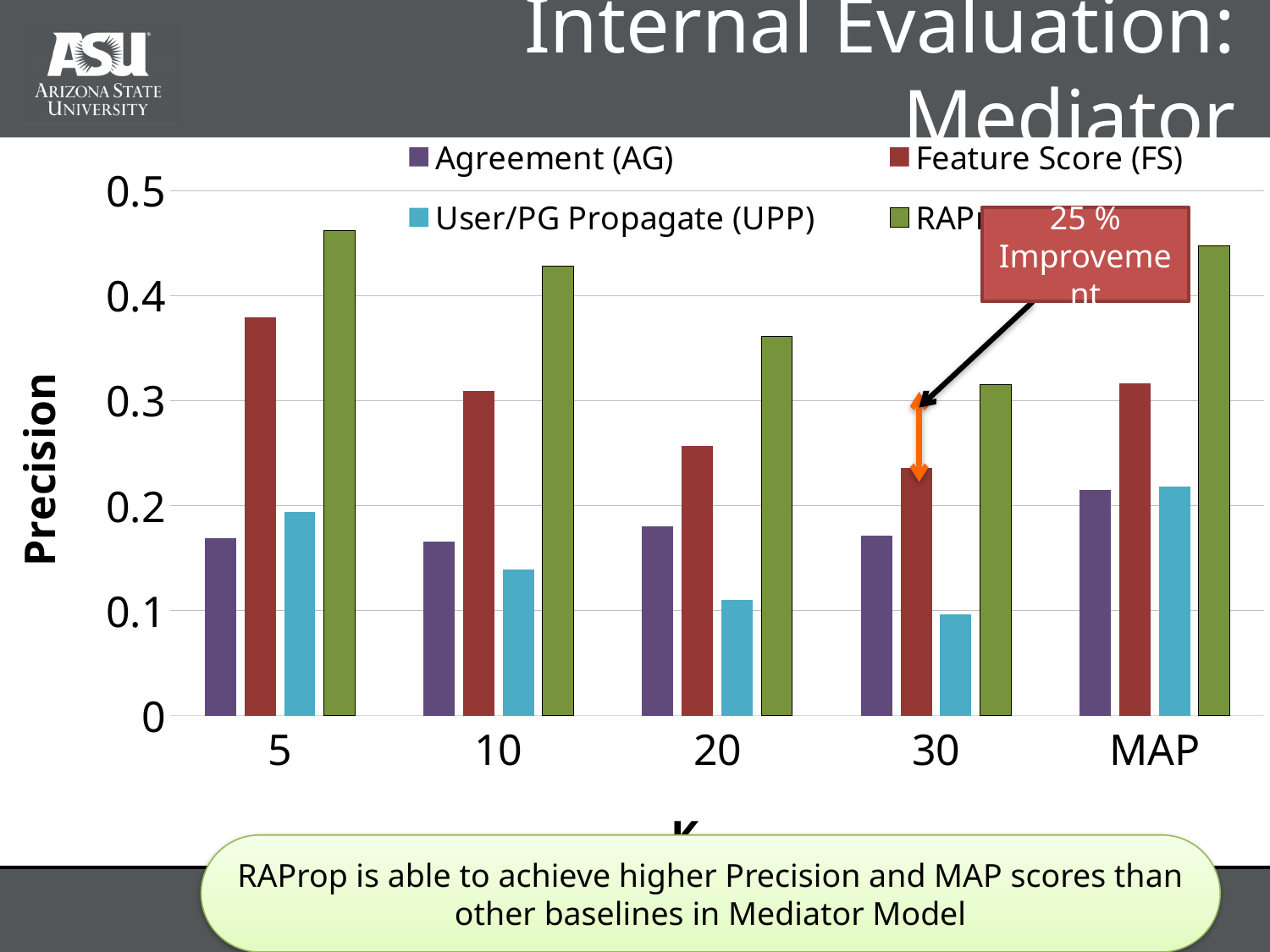
How many categories are shown along the x axis? 5 What kind of chart is shown on the slide? bar chart Which series has the highest precision at K = 5? RAProp What is the label on the y axis of the chart? Precision Is the Feature Score (FS) value larger at K = 5 or at K = 30? 5 How many series does the legend list? 4 Is the Feature Score (FS) value at K = 5 greater or less than 0.3? greater What percentage improvement does the callout on the chart indicate? 25 % Which series has the lowest precision at K = 20? User/PG Propagate (UPP) Does the RAProp precision rise or fall as K goes from 5 to 30? fall Is the RAProp value at K = 10 greater or less than 0.4? greater